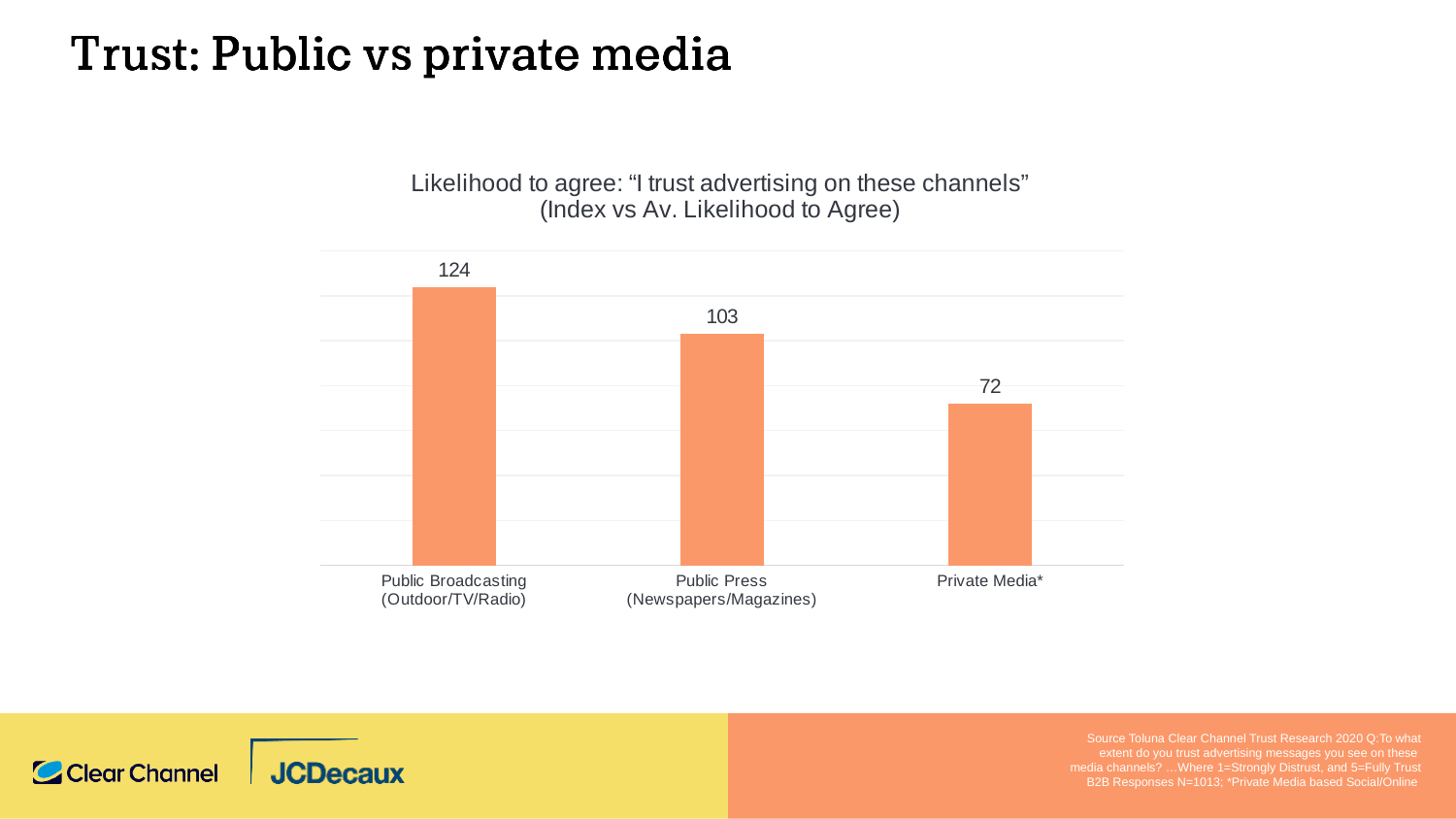
What is the title of the chart? Likelihood to agree: "I trust advertising on these channels" (Index vs Av. Likelihood to Agree) What is the value for Public Broadcasting (Outdoor/TV/Radio)? 124 What kind of chart is shown on the slide? Bar chart What is the difference between the values for Public Broadcasting and Private Media*? 52 Do the values rise or fall from left to right across the categories? Fall What is the value for Private Media*? 72 Which category has the lowest value? Private Media* What is the value for Public Press (Newspapers/Magazines)? 103 How many categories are shown in the chart? 3 Which category has the highest value? Public Broadcasting (Outdoor/TV/Radio) Which is larger, the value for Public Press or the value for Private Media*? Public Press What is the difference between the values for Public Broadcasting and Public Press? 21